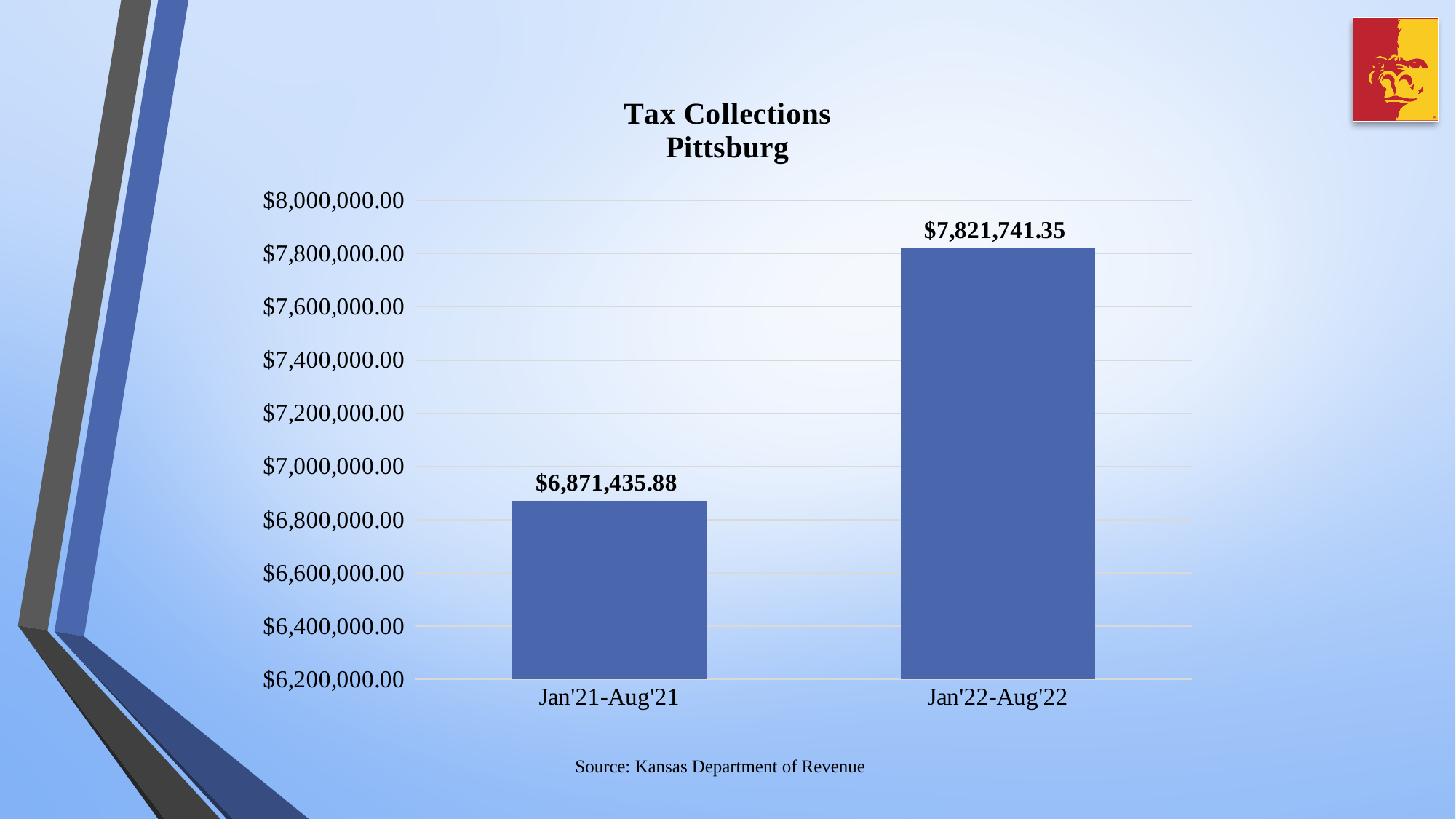
Which is larger, the tax collections for Jan'21-Aug'21 or for Jan'22-Aug'22? Jan'22-Aug'22 Is the value for Jan'21-Aug'21 greater or less than $7,000,000.00? less Do tax collections rise or fall from Jan'21-Aug'21 to Jan'22-Aug'22? Rise What kind of chart is shown on the slide? Bar chart Which period has the lowest tax collections? Jan'21-Aug'21 What is the difference in tax collections between Jan'22-Aug'22 and Jan'21-Aug'21? $950,305.47 Is the value for Jan'22-Aug'22 greater or less than $7,600,000.00? greater How many periods are shown in the chart? 2 What is the tax collection value for Jan'22-Aug'22? $7,821,741.35 What is the title of the chart? Tax Collections Pittsburg Which period has the highest tax collections? Jan'22-Aug'22 What is the tax collection value for Jan'21-Aug'21? $6,871,435.88